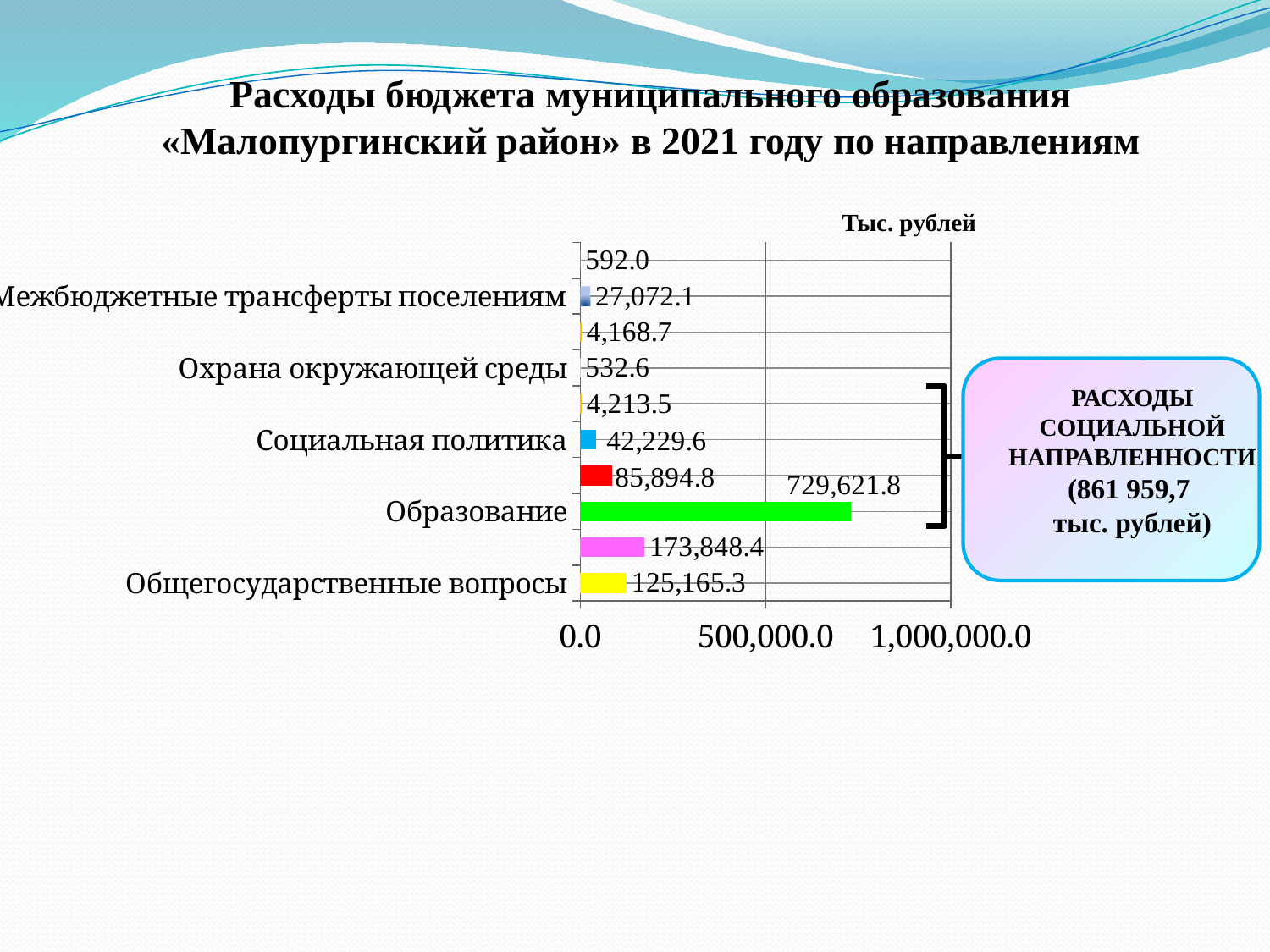
What is the value for Межбюджетные трансферты поселениям? 27,072.1 Which category has the lowest value? Охрана окружающей среды Which category has the highest value? Образование Is the value for Образование greater or less than 500,000.0? greater What is the value for Образование? 729,621.8 Which is larger, the value for Социальная политика or the value for Межбюджетные трансферты поселениям? Социальная политика What is the value for Охрана окружающей среды? 532.6 What is the value for Общегосударственные вопросы? 125,165.3 What type of chart is shown on the slide? Bar chart What is the value for Социальная политика? 42,229.6 What is the difference between the values for Образование and Общегосударственные вопросы? 604,456.5 How many bars are plotted in the chart? 10